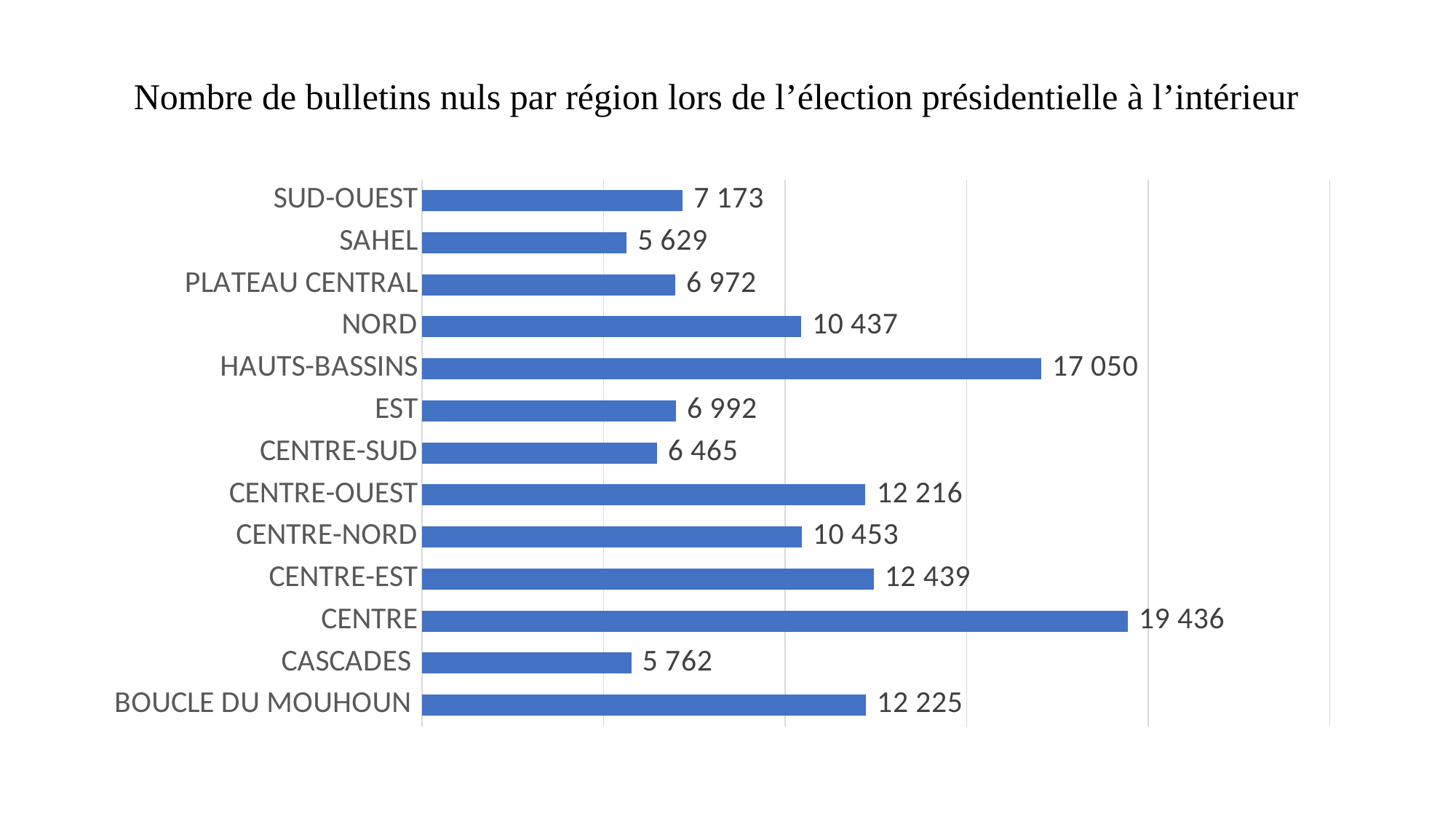
Which region has the lowest number of null ballots? SAHEL What is the value shown for SAHEL? 5 629 Which has a larger value, NORD or CENTRE-SUD? NORD Which has a larger value, CASCADES or SUD-OUEST? SUD-OUEST What kind of chart is shown on the slide? Bar chart What is the number of null ballots for HAUTS-BASSINS? 17 050 How many regions are shown in the chart? 13 Which region has the highest number of null ballots? CENTRE What is the value shown for BOUCLE DU MOUHOUN? 12 225 What is the difference between the values for CENTRE-EST and CENTRE-OUEST? 223 What is the title of the chart? Nombre de bulletins nuls par région lors de l'élection présidentielle à l'intérieur What is the difference between the values for CENTRE and HAUTS-BASSINS? 2 386